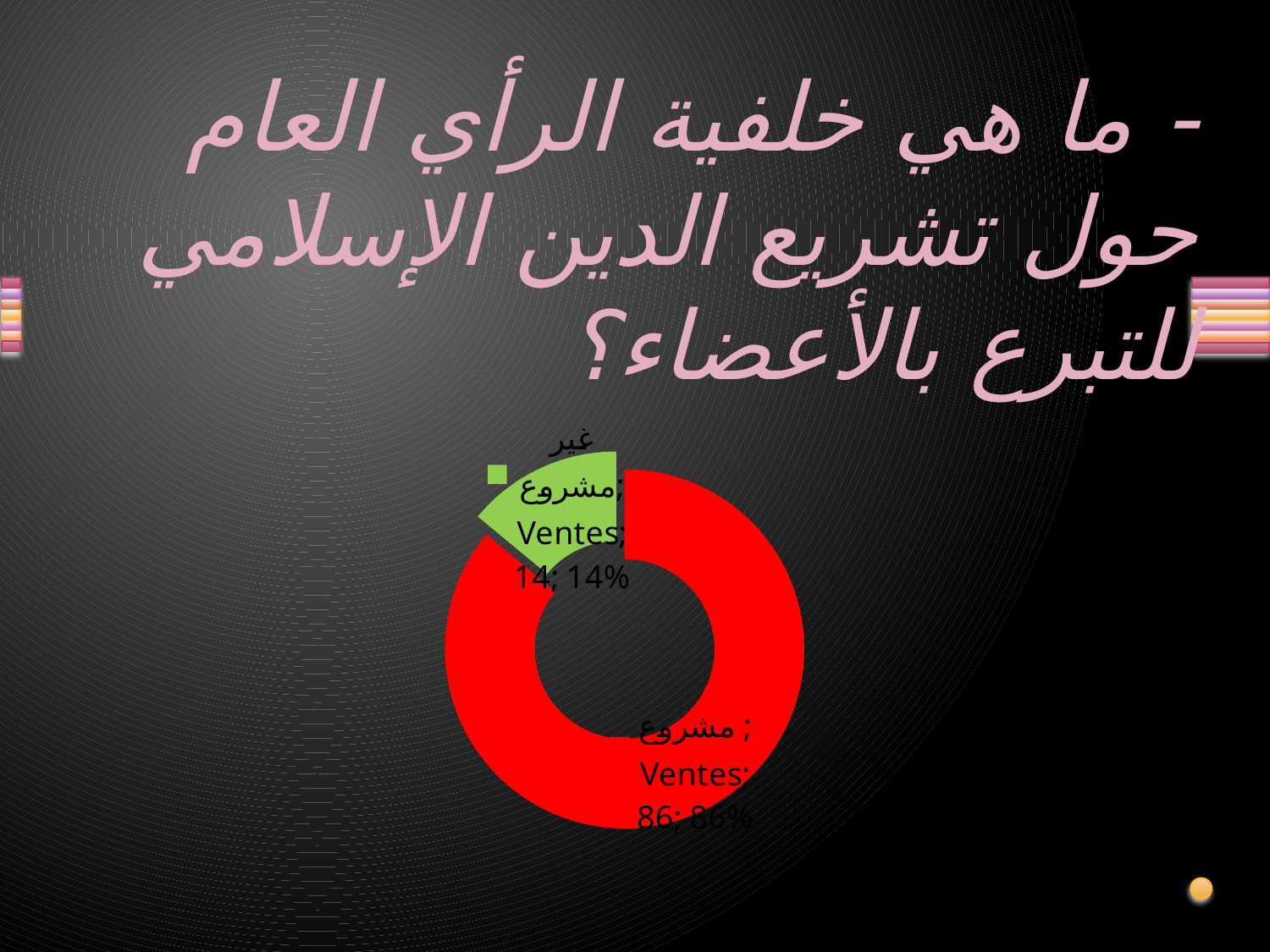
What is the total of the two slice values in the doughnut chart? 100 How many slices does the doughnut chart have? 2 Which slice is larger, مشروع or غير مشروع? مشروع What percentage share does the slice labelled مشروع have? 86% Which slice is the smallest in the doughnut chart? غير مشروع What is the difference between the values for مشروع and غير مشروع? 72 What percentage share does the slice labelled غير مشروع have? 14% What is the value for the slice labelled مشروع? 86 Which slice is the largest in the doughnut chart? مشروع What kind of chart is shown on the slide? doughnut chart What is the value for the slice labelled غير مشروع? 14 What colour is the slice labelled غير مشروع? green